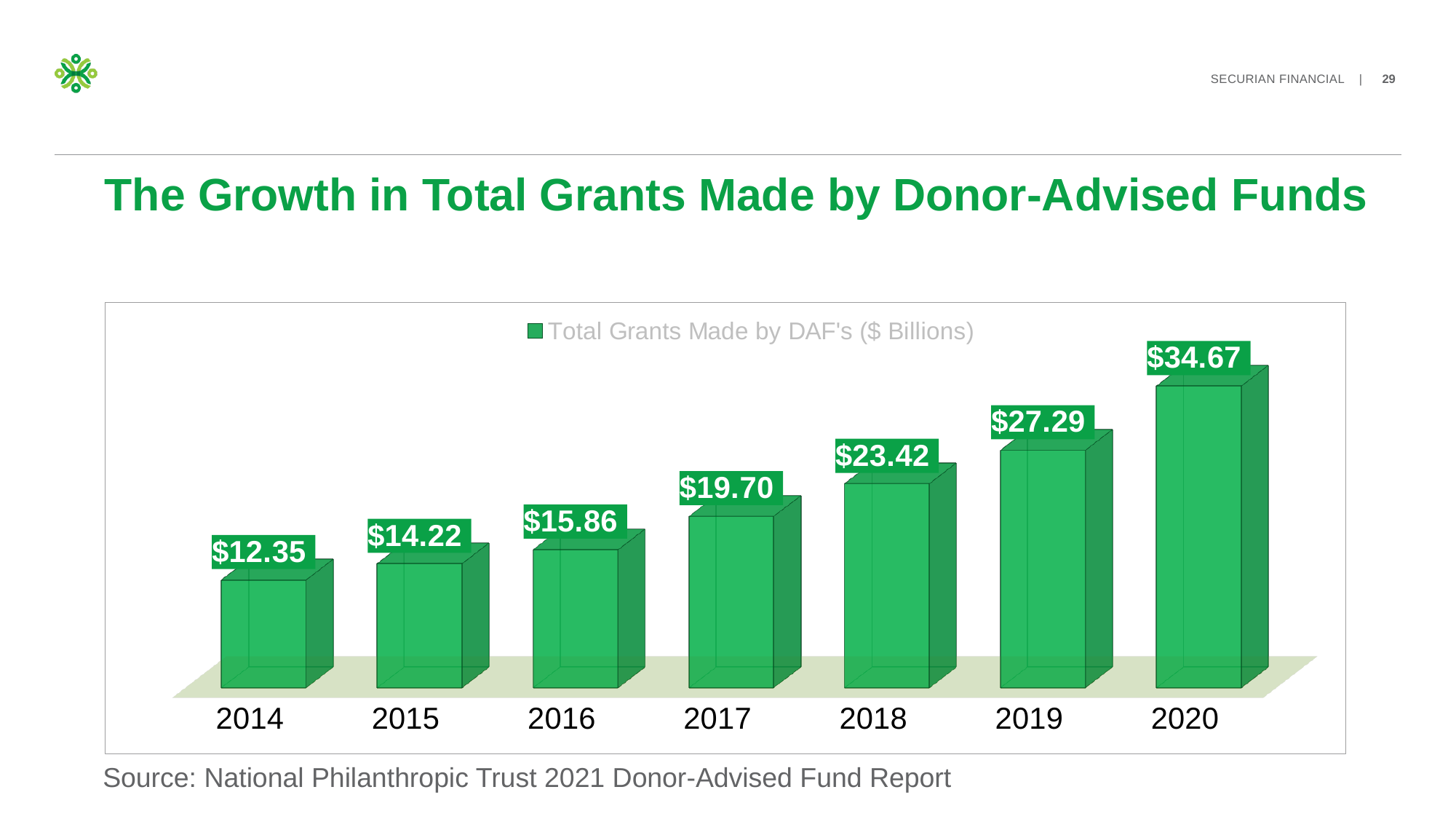
What is the difference between the values for 2016 and 2015? $1.64 What is the difference between the values for 2020 and 2019? $7.38 How many series does the legend list? 1 Which year has the highest value? 2020 Which is larger, the value for 2018 or the value for 2017? 2018 Do the values rise or fall from 2014 to 2020? rise What is the value for 2019? $27.29 Which year has the lowest value? 2014 What is the value for 2014? $12.35 What is the value for 2017? $19.70 What kind of chart is shown? bar chart How many years are shown on the chart? 7